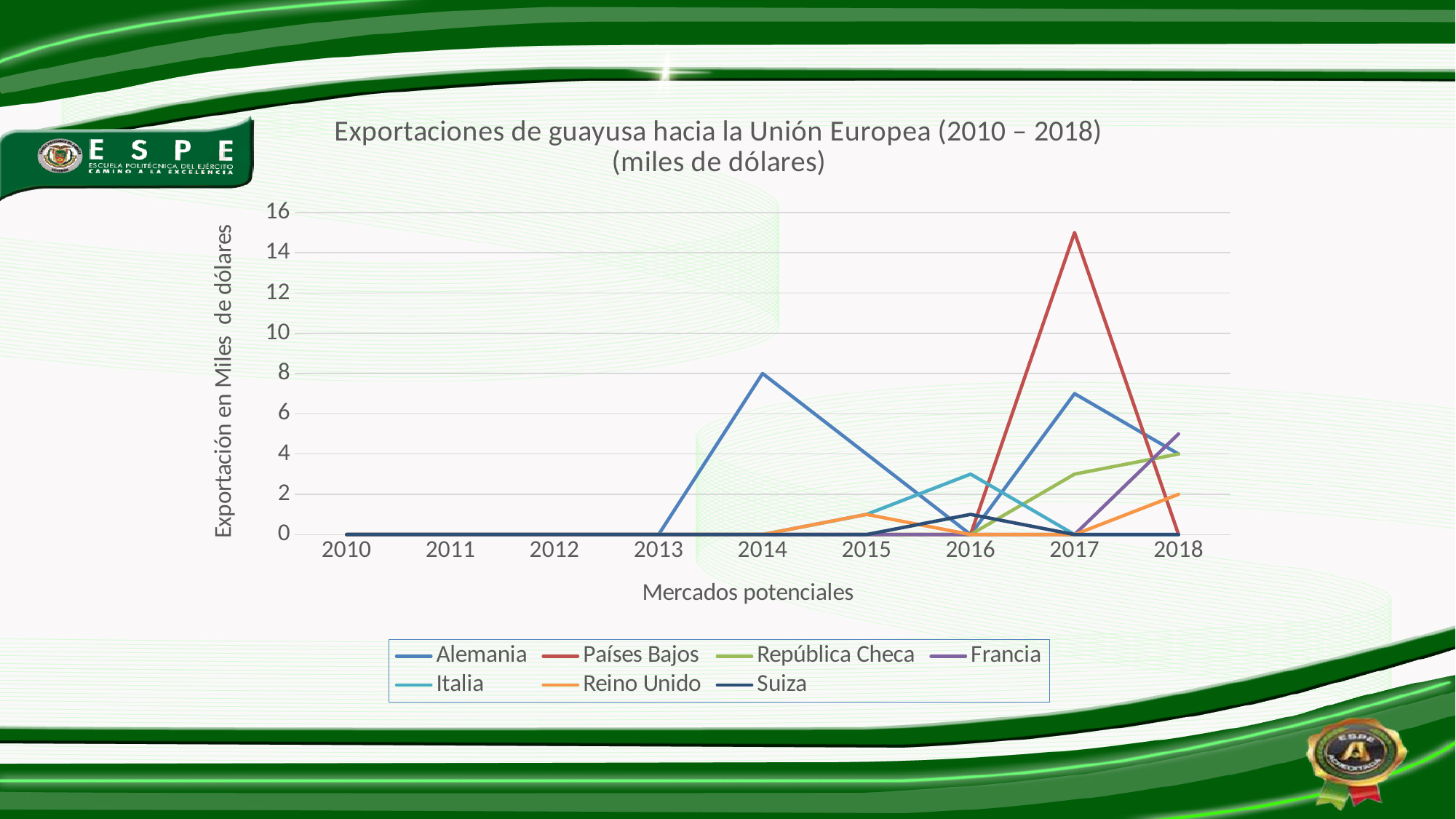
What is the difference between the value for Alemania in 2014 and the value for República Checa in 2018? 4 What is the value for Alemania in 2014? 8 What kind of chart is shown on the slide? line chart How many series does the legend list? 7 Is the value for Países Bajos in 2017 greater or less than 14? greater How many years are shown on the x axis? 9 Which series reaches the highest value in the chart? Países Bajos What is the value for República Checa in 2018? 4 What is the value for Reino Unido in 2018? 2 What is the value for Países Bajos in 2018? 0 In which year does Alemania reach its highest value? 2014 Is the value for Alemania in 2017 greater or less than 6? greater